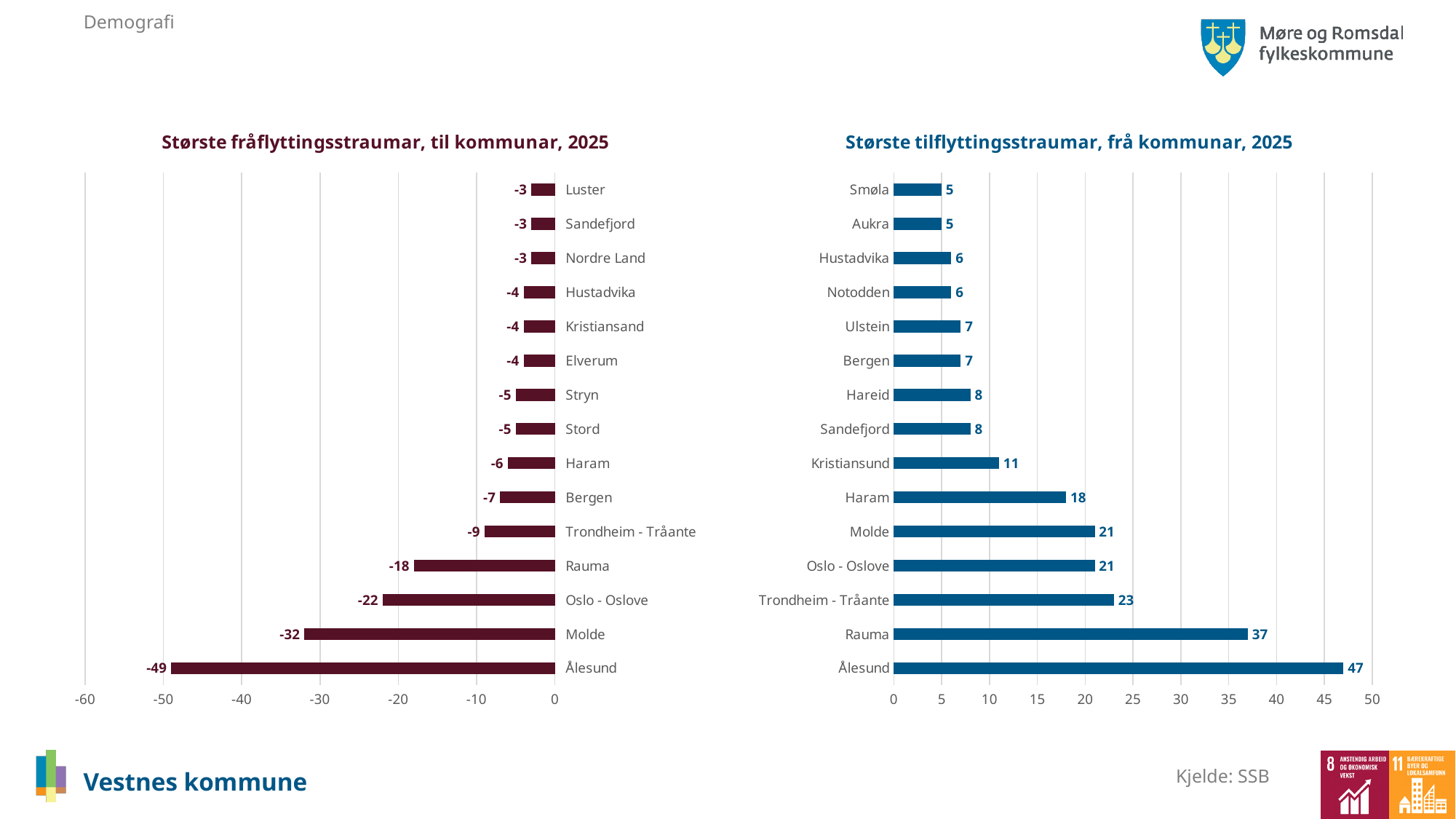
In the chart 'Største tilflyttingsstraumar, frå kommunar, 2025', what is the value for Rauma? 37 How many municipalities are shown in the chart 'Største tilflyttingsstraumar, frå kommunar, 2025'? 15 In the chart 'Største tilflyttingsstraumar, frå kommunar, 2025', which municipality has the highest value? Ålesund In the chart 'Største fråflyttingsstraumar, til kommunar, 2025', what is the difference between the values for Oslo - Oslove and Rauma? 4 In the chart 'Største tilflyttingsstraumar, frå kommunar, 2025', what is the value for Molde? 21 In the chart 'Største tilflyttingsstraumar, frå kommunar, 2025', is the value for Trondheim - Tråante greater or less than 20? greater In the chart 'Største fråflyttingsstraumar, til kommunar, 2025', which municipality has the largest outflow (most negative value)? Ålesund What type of chart is the chart on the right of the slide? Bar chart In the chart 'Største tilflyttingsstraumar, frå kommunar, 2025', which is larger, the value for Haram or the value for Kristiansund? Haram How many municipalities are shown in the chart 'Største fråflyttingsstraumar, til kommunar, 2025'? 15 In the chart 'Største fråflyttingsstraumar, til kommunar, 2025', what is the value for Molde? -32 In the chart 'Største tilflyttingsstraumar, frå kommunar, 2025', what is the difference between the values for Ålesund and Rauma? 10